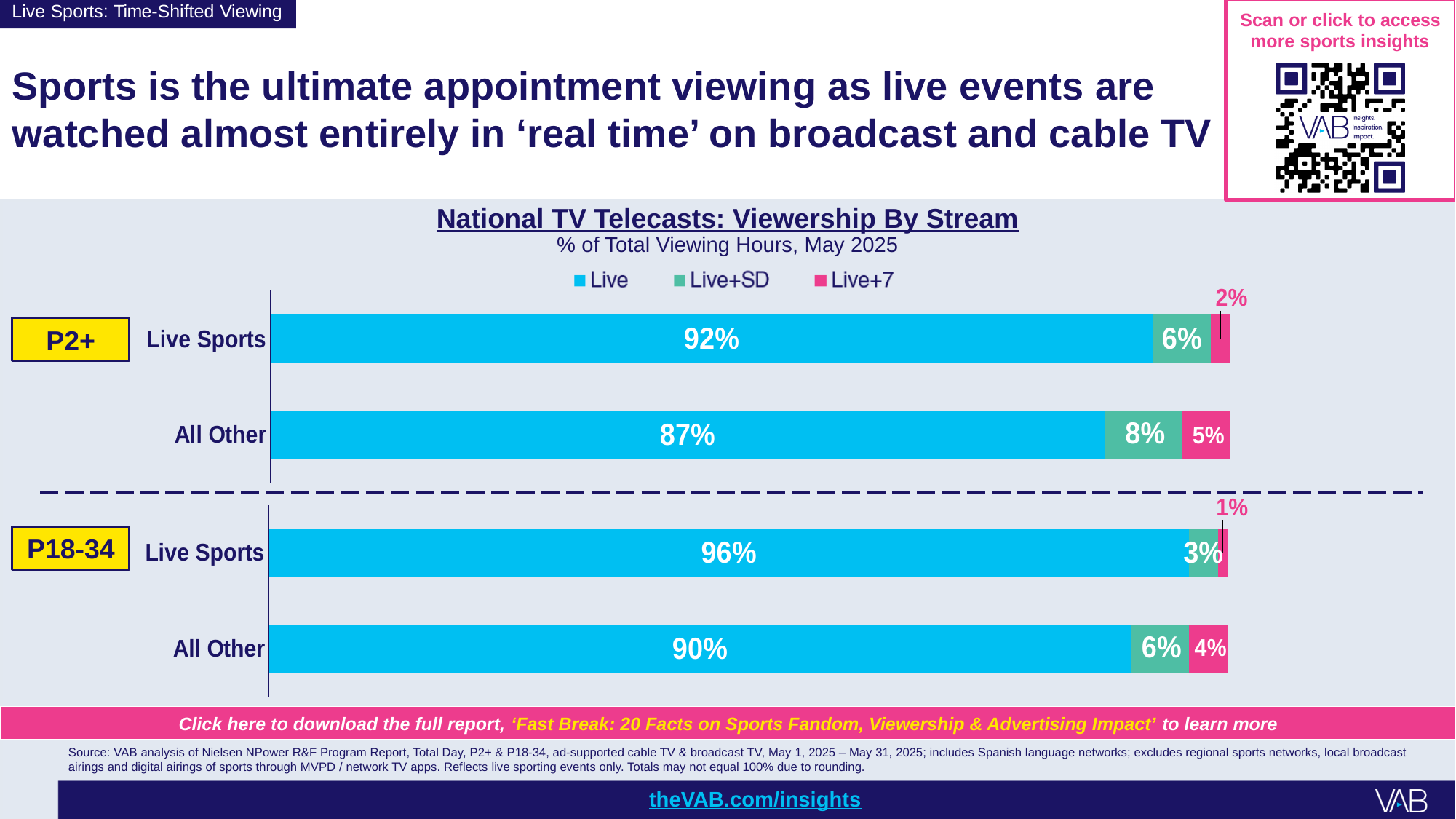
What is the Live+SD share for Live Sports among P18-34? 3% Which is larger, the Live+7 share for P2+ Live Sports or for P2+ All Other? P2+ All Other How many bars are plotted in the chart? 4 What is the difference in Live share between Live Sports and All Other among P18-34? 6% What is the Live+7 share for All Other programming among P2+? 5% What kind of chart is shown on the slide? Stacked bar chart How many series does the legend list? 3 What is the Live share for Live Sports among P2+? 92% Which bar has the highest Live share? P18-34 Live Sports What is the title of the chart? National TV Telecasts: Viewership By Stream Which bar has the lowest Live share? P2+ All Other What is the Live share for All Other programming among P18-34? 90%